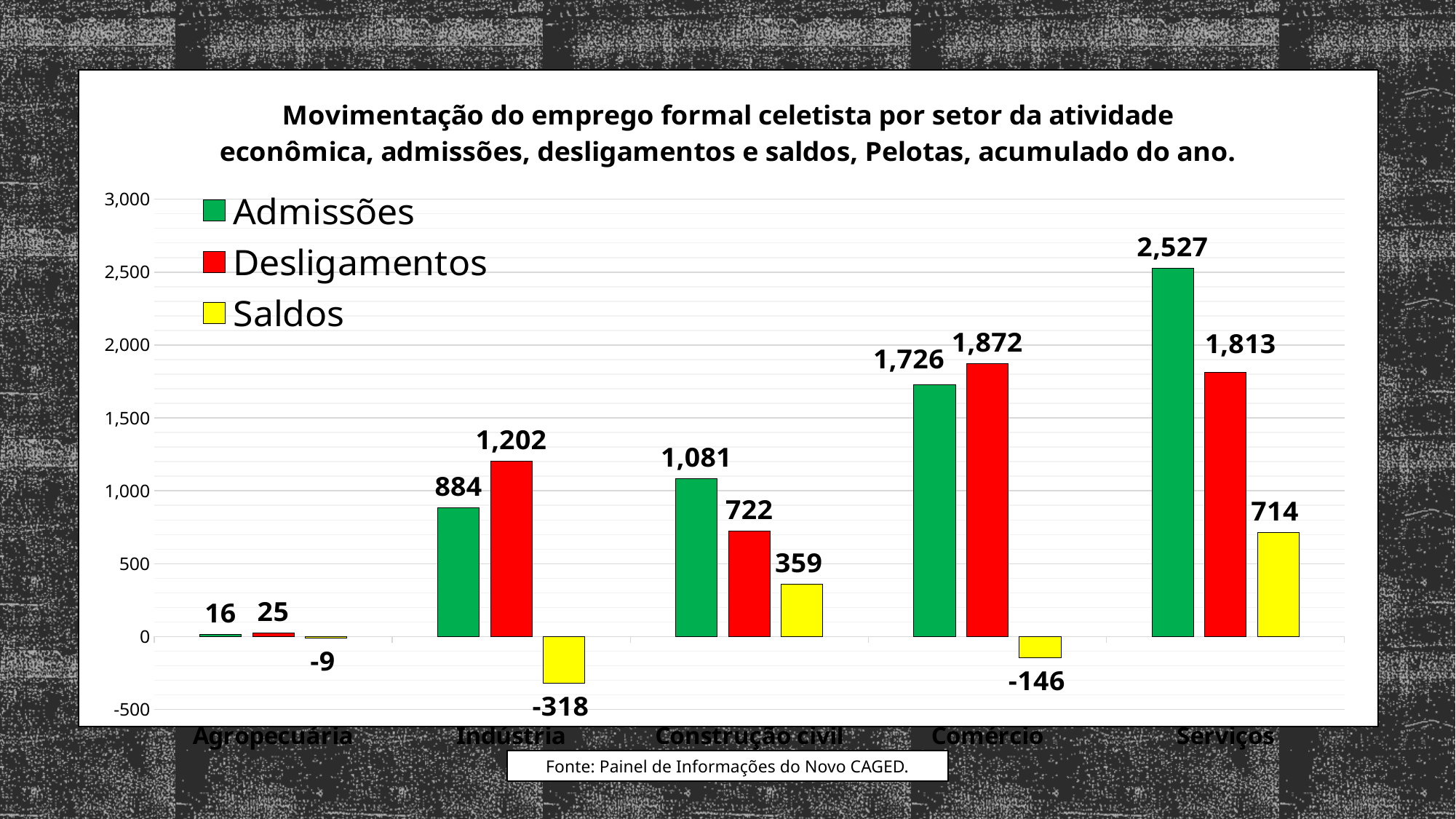
Which sector has the highest Admissões value? Serviços What is the Desligamentos value for Indústria? 1,202 How many series does the legend list? 3 What is the Saldos value for Construção civil? 359 How many sectors are shown on the x axis? 5 What kind of chart is shown on the slide? Bar chart Which sector has the lowest Saldos value? Indústria What is the Admissões value for Serviços? 2,527 Which colour represents the Saldos series in the legend? Yellow What is the difference between Desligamentos and Admissões for Comércio? 146 Which is larger for Construção civil, Admissões or Desligamentos? Admissões What is the Saldos value for Comércio? -146